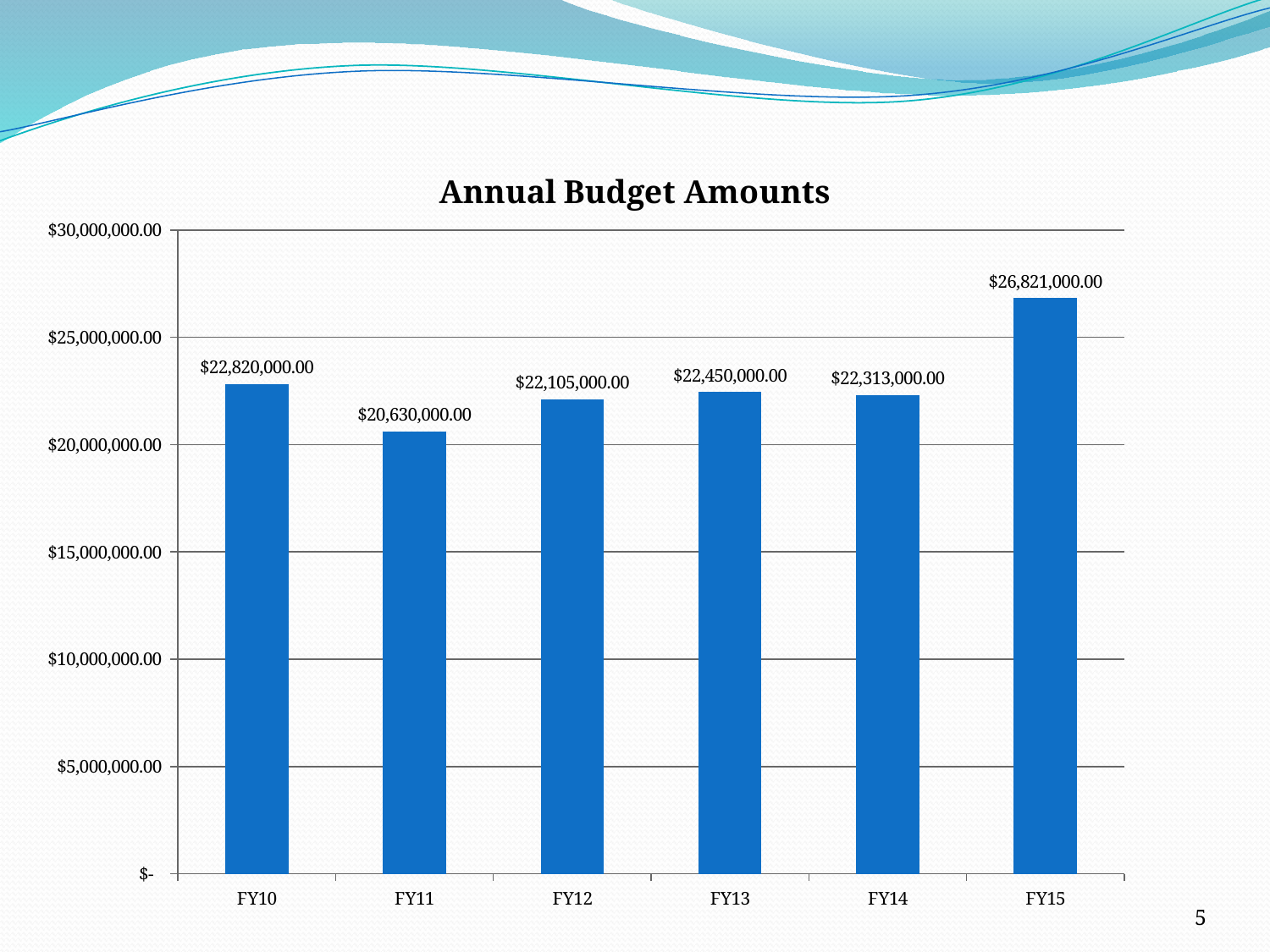
Which fiscal year has the lowest annual budget amount? FY11 What type of chart is shown on the slide? Bar chart What is the annual budget amount for FY15? $26,821,000.00 Is the budget amount for FY15 greater or less than $25,000,000.00? greater What is the annual budget amount for FY10? $22,820,000.00 Which fiscal year has the highest annual budget amount? FY15 What is the annual budget amount for FY13? $22,450,000.00 What is the title of the chart? Annual Budget Amounts What is the difference between the FY15 and FY14 budget amounts? $4,508,000.00 How many fiscal years are shown in the chart? 6 Which is larger, the budget amount for FY13 or for FY14? FY13 What is the difference between the FY10 and FY11 budget amounts? $2,190,000.00